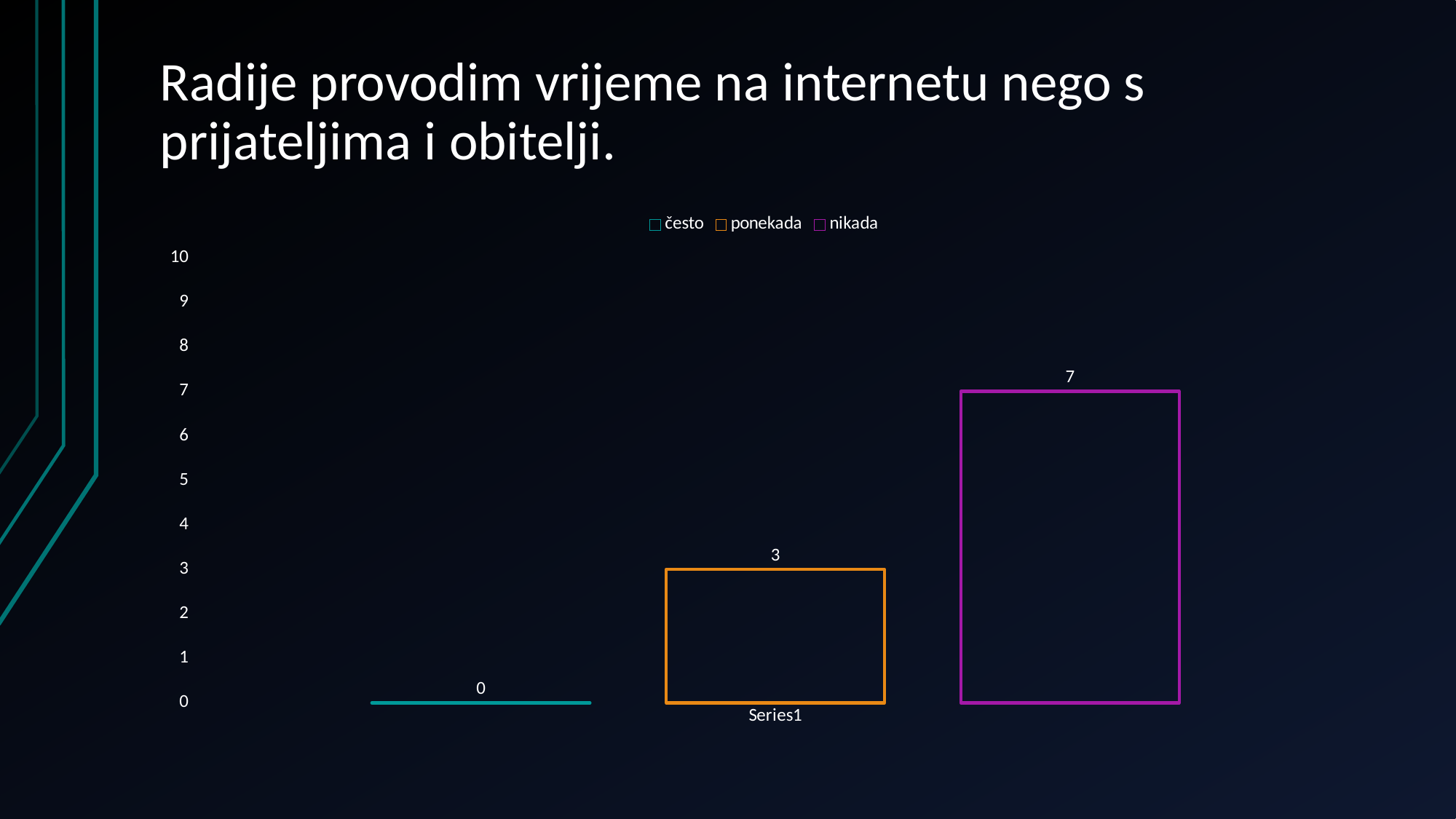
Which series has the highest value? nikada Is the value for "nikada" greater or less than 5? greater What is the value for "često"? 0 What is the value for "nikada"? 7 How many series does the legend list? 3 What is the difference between the values for "nikada" and "ponekada"? 4 Which is larger, the value for "ponekada" or the value for "nikada"? nikada What is the category label shown on the x axis? Series1 Which series has the lowest value? često What kind of chart is shown on the slide? bar chart What is the value for "ponekada"? 3 What is the total of the three plotted values? 10